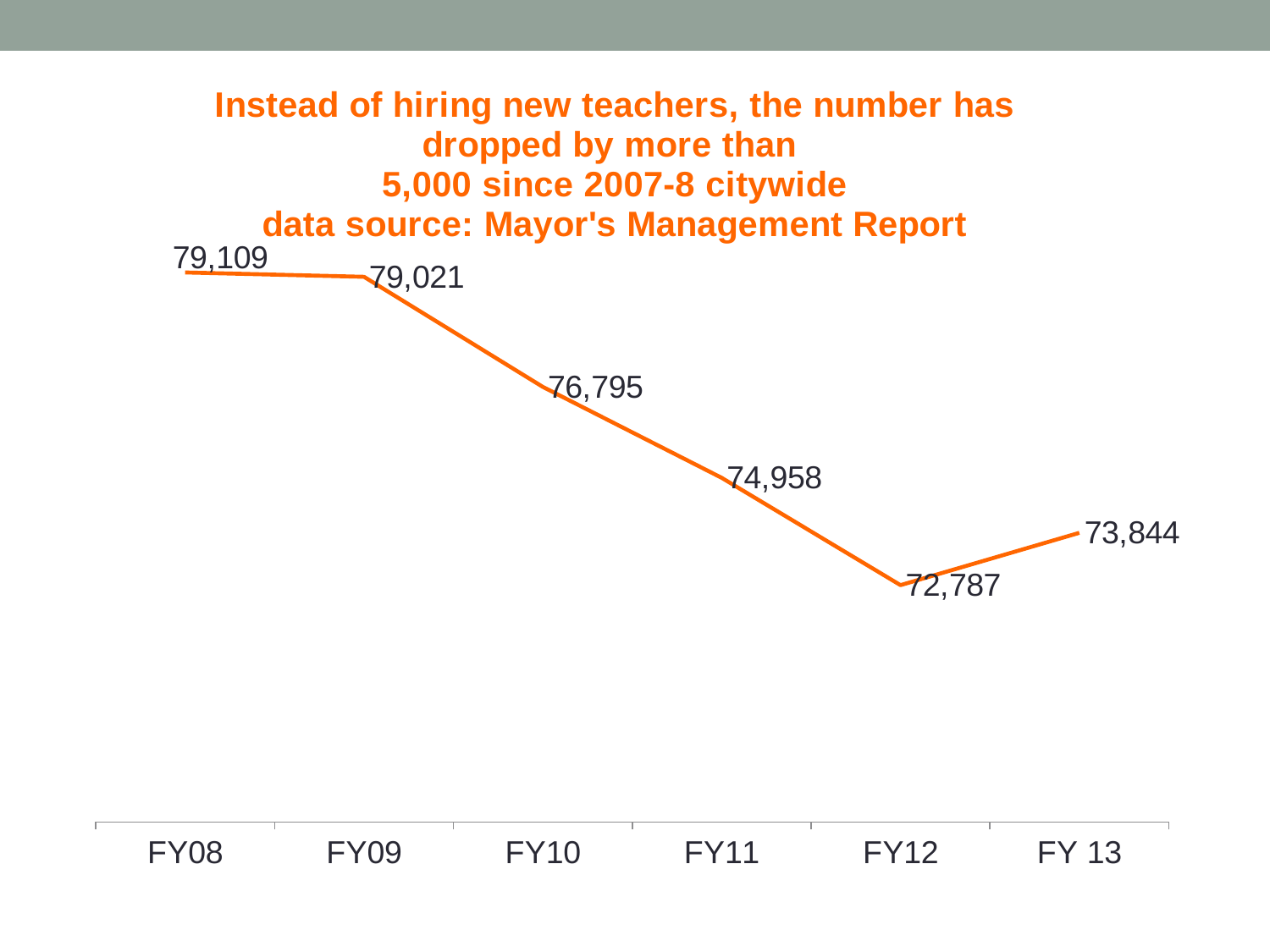
Do the values generally rise or fall from FY08 to FY12? fall What is the difference between the values for FY11 and FY10? 1,837 Which fiscal year has the lowest value? FY12 What is the value for FY12? 72,787 What is the value for FY10? 76,795 What kind of chart is shown on the slide? line chart What is the difference between the values for FY08 and FY12? 6,322 Which fiscal year has the highest value? FY08 How many fiscal years are plotted on the x axis? 6 Which is larger, the value for FY09 or the value for FY11? FY09 What is the value for FY 13? 73,844 What is the value for FY08? 79,109